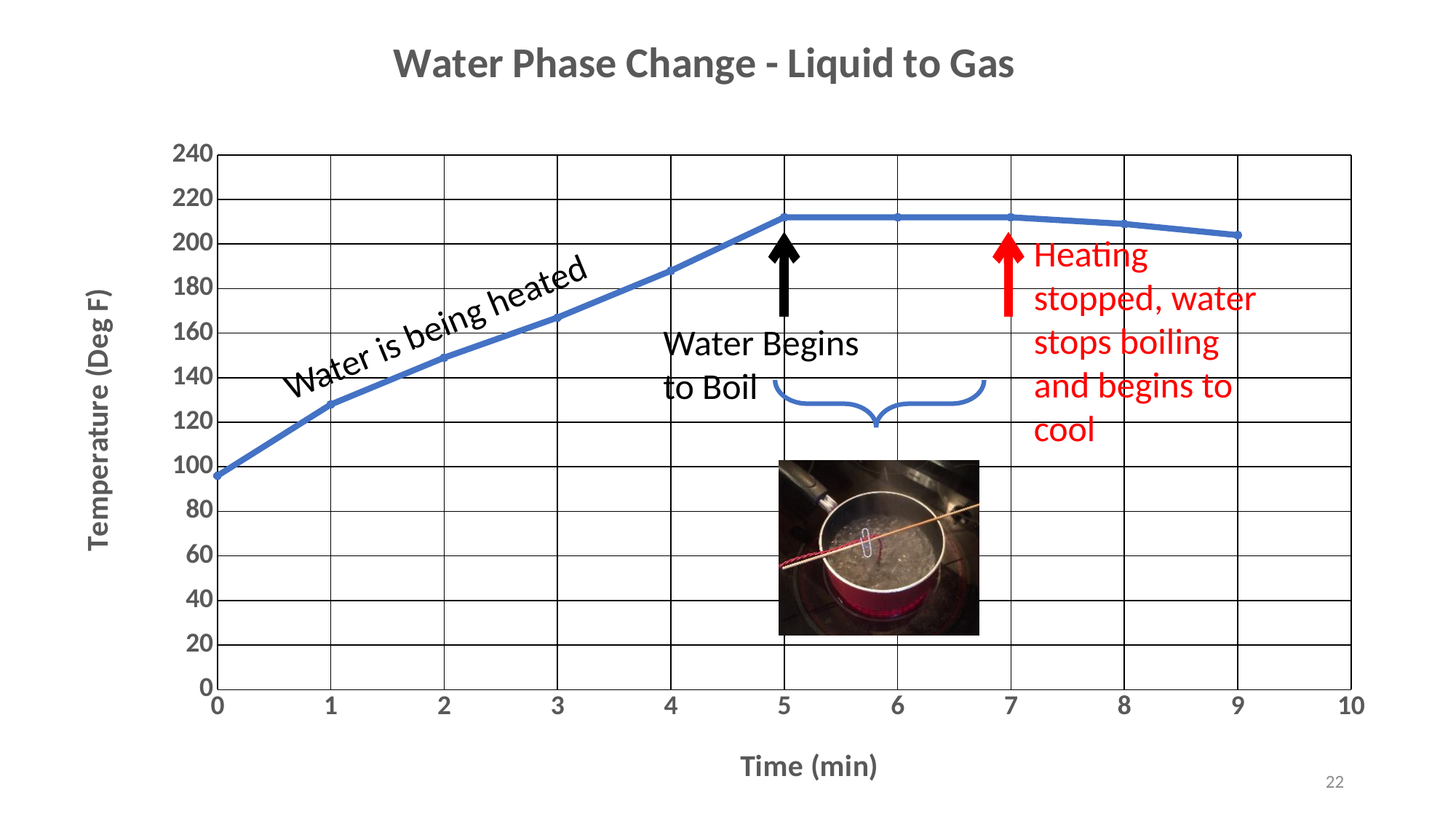
Is the temperature at 4 min greater or less than 180? greater How many data points are plotted on the line? 10 Is the temperature at 0 min greater or less than 100? less Does the temperature rise or fall between 0 min and 5 min? rise Is the temperature at 2 min greater or less than 160? less At which time is the temperature lowest? 0 min What kind of chart is shown on the slide? line chart Which is higher, the temperature at 4 min or at 2 min? 4 min What is the title of the chart? Water Phase Change - Liquid to Gas What is the label of the vertical axis? Temperature (Deg F)